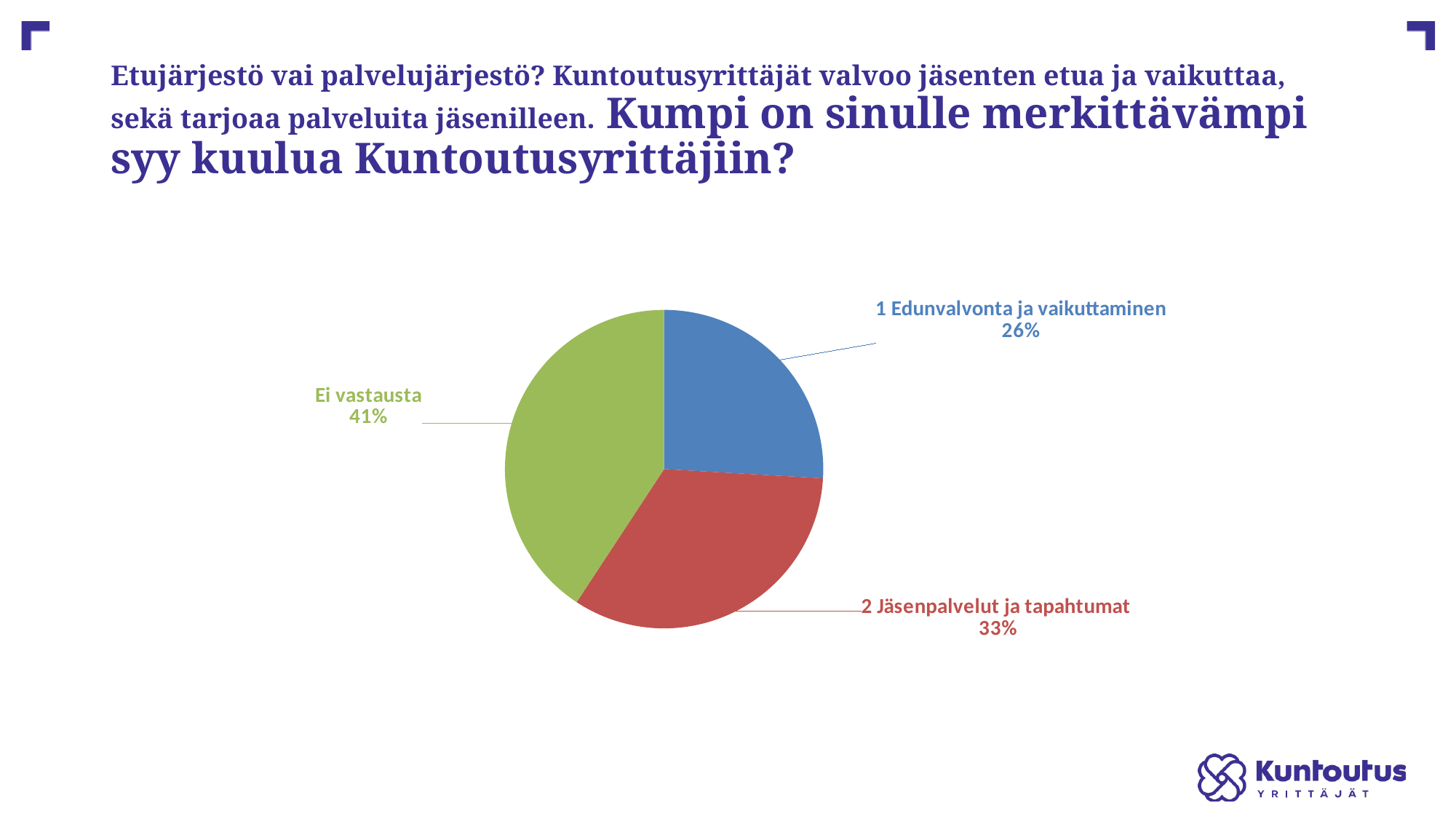
What kind of chart is shown on the slide? pie chart What share of the pie does "1 Edunvalvonta ja vaikuttaminen" have? 26% What is the difference in percentage points between "2 Jäsenpalvelut ja tapahtumat" and "1 Edunvalvonta ja vaikuttaminen"? 7 Which is larger, the share for "2 Jäsenpalvelut ja tapahtumat" or the share for "1 Edunvalvonta ja vaikuttaminen"? 2 Jäsenpalvelut ja tapahtumat Which slice of the pie is the smallest? 1 Edunvalvonta ja vaikuttaminen Which slice of the pie is the largest? Ei vastausta What colour is the "Ei vastausta" slice? green What share of the pie does "Ei vastausta" have? 41% What colour is the "1 Edunvalvonta ja vaikuttaminen" slice? blue What is the difference in percentage points between "Ei vastausta" and "1 Edunvalvonta ja vaikuttaminen"? 15 How many slices does the pie chart have? 3 What share of the pie does "2 Jäsenpalvelut ja tapahtumat" have? 33%